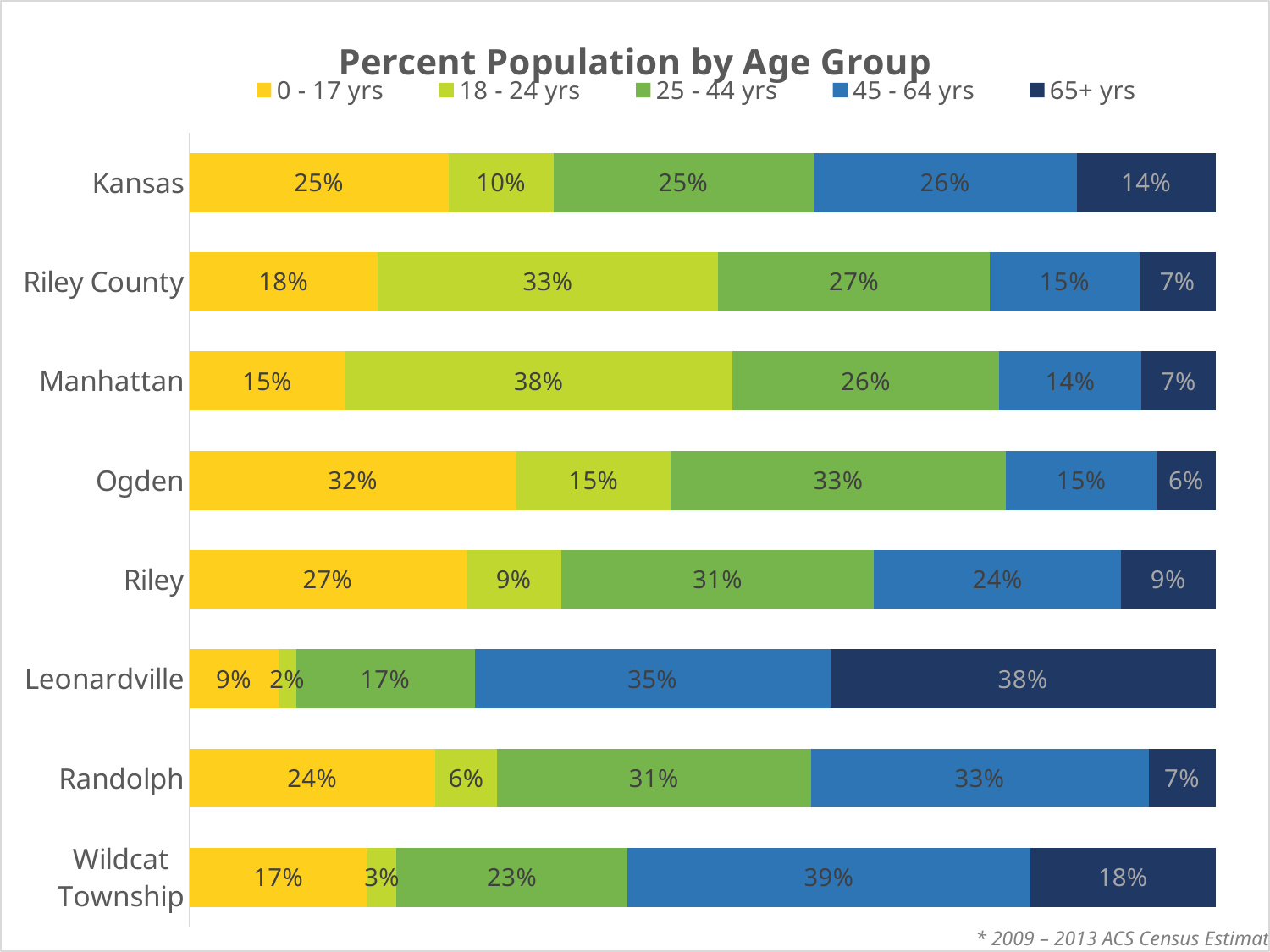
What is the value for the 65+ yrs group in Leonardville? 38% What is the total of the Kansas bar across all age groups? 100% Which area has the highest percentage in the 0 - 17 yrs group? Ogden Which has a larger 45 - 64 yrs percentage, Randolph or Riley? Randolph Which area has the lowest percentage in the 18 - 24 yrs group? Leonardville How much larger is Riley County's 18 - 24 yrs percentage than Kansas's? 23 percentage points What share of Wildcat Township's population is 45 - 64 yrs? 39% How many areas are shown on the chart? 8 What percentage of Manhattan's population is in the 18 - 24 yrs age group? 38% What kind of chart is this? Stacked bar chart How many age groups does the legend list? 5 What is the title of the chart? Percent Population by Age Group